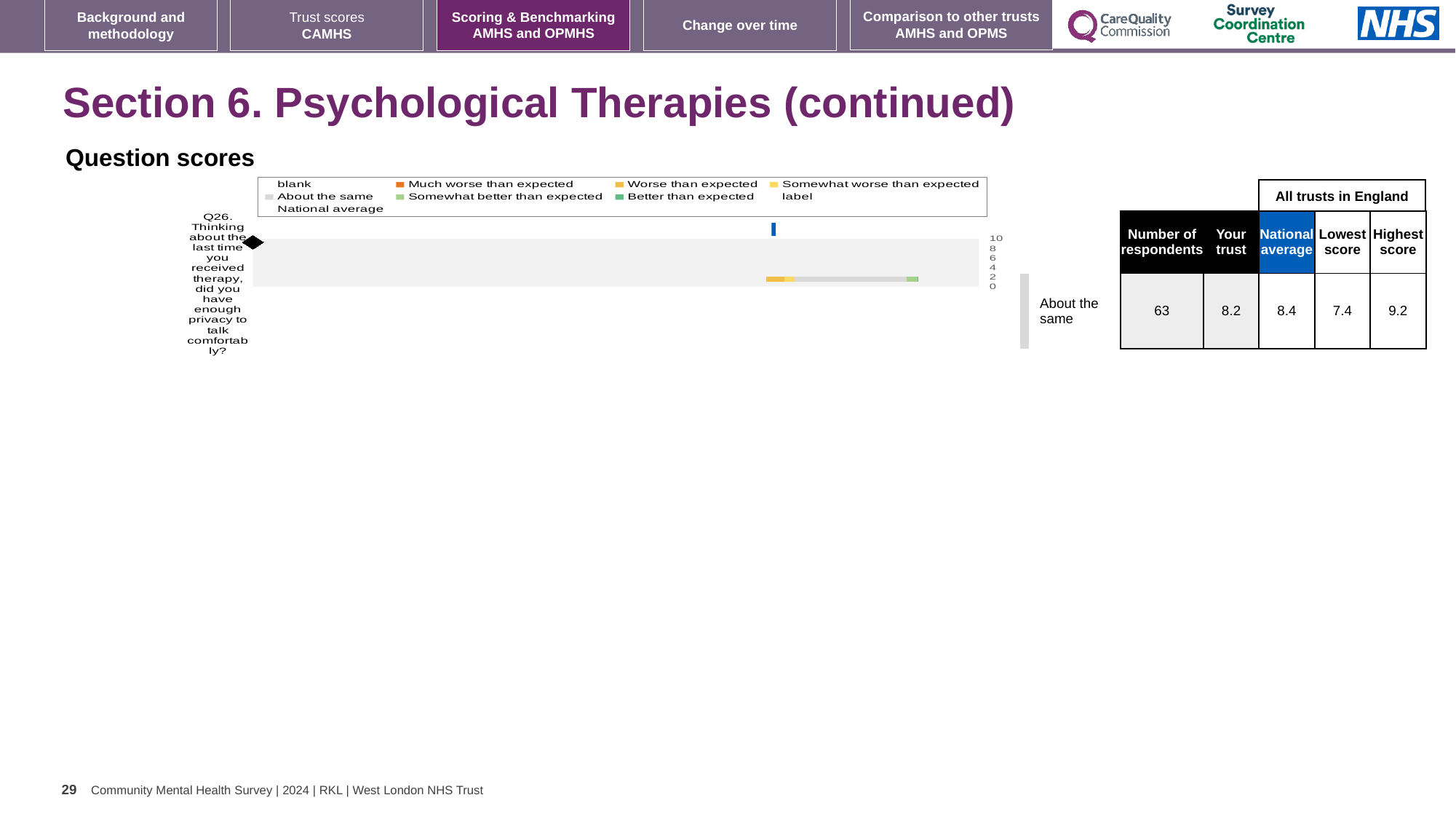
How many questions are plotted on the chart? 1 In the table next to the chart, what is the lowest score among all trusts in England for Q26? 7.4 Which is larger for Q26, the 'Your trust' score or the national average? National average What benchmark category is shown beside the chart for Q26? About the same In the table next to the chart, what is the 'Your trust' score for Q26? 8.2 What is the difference between the highest score and the lowest score for Q26 in the table? 1.8 In the table next to the chart, what is the national average for Q26? 8.4 What is the highest value shown on the chart's axis? 10 In the table next to the chart, what is the highest score among all trusts in England for Q26? 9.2 Which question number is plotted on the chart? Q26 What kind of chart is shown under 'Question scores'? bar chart In the table next to the chart, what is the number of respondents for Q26? 63